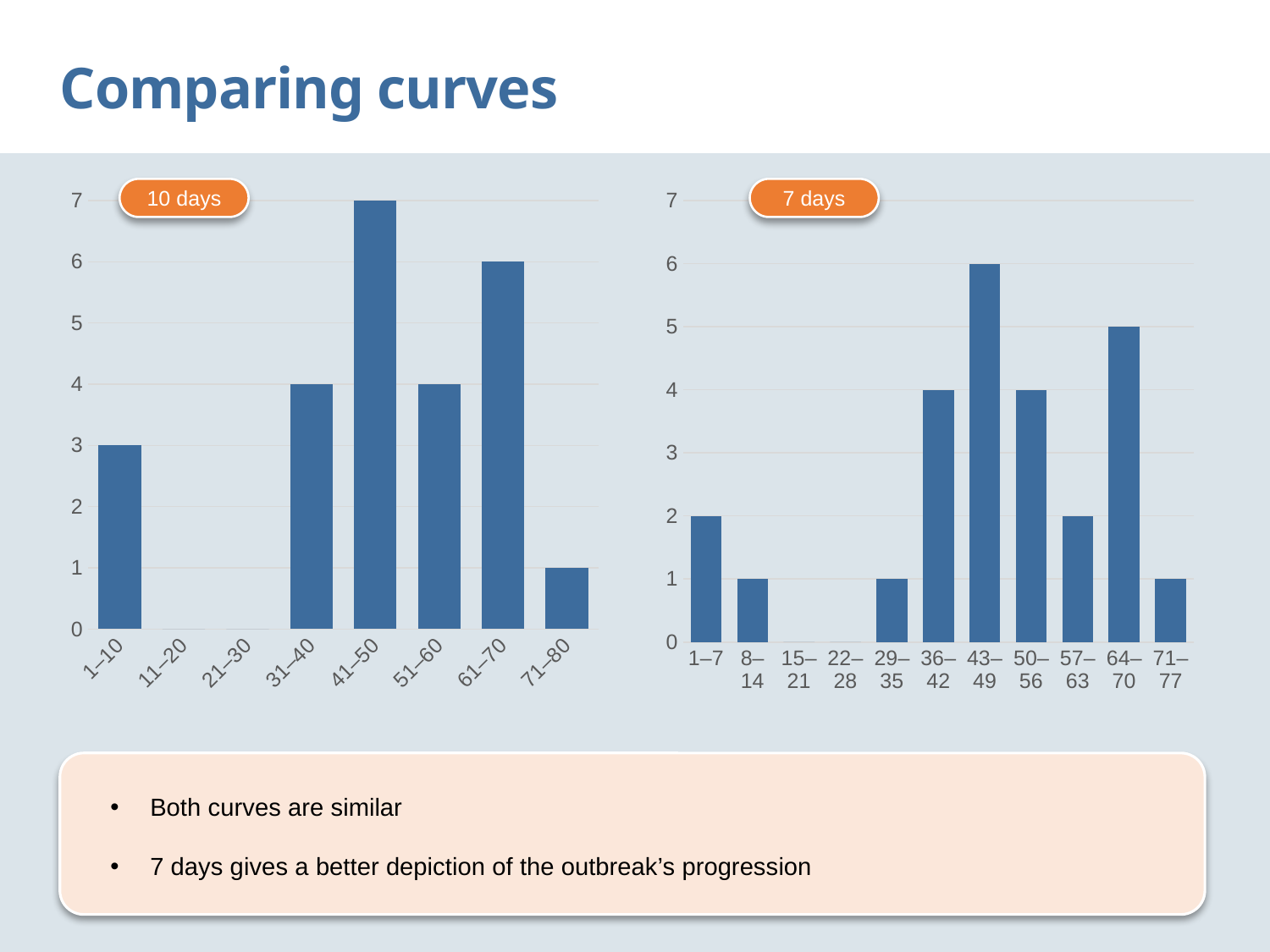
In the 7 days chart, what is the value for the 1–7 category? 2 In the 7 days chart, what is the value for the 64–70 category? 5 In the 7 days chart, how many categories are shown on the x axis? 11 What kind of chart is the 7 days chart? Bar chart In the 7 days chart, which is larger, the value for 36–42 or the value for 57–63? 36–42 In the 10 days chart, what is the value for the 41–50 category? 7 In the 10 days chart, what is the value for the 1–10 category? 3 In the 10 days chart, which category has the highest value? 41–50 In the 10 days chart, what is the difference between the values for 61–70 and 71–80? 5 In the 10 days chart, how many categories are shown on the x axis? 8 In the 7 days chart, which category has the highest value? 43–49 What is the title of the slide? Comparing curves